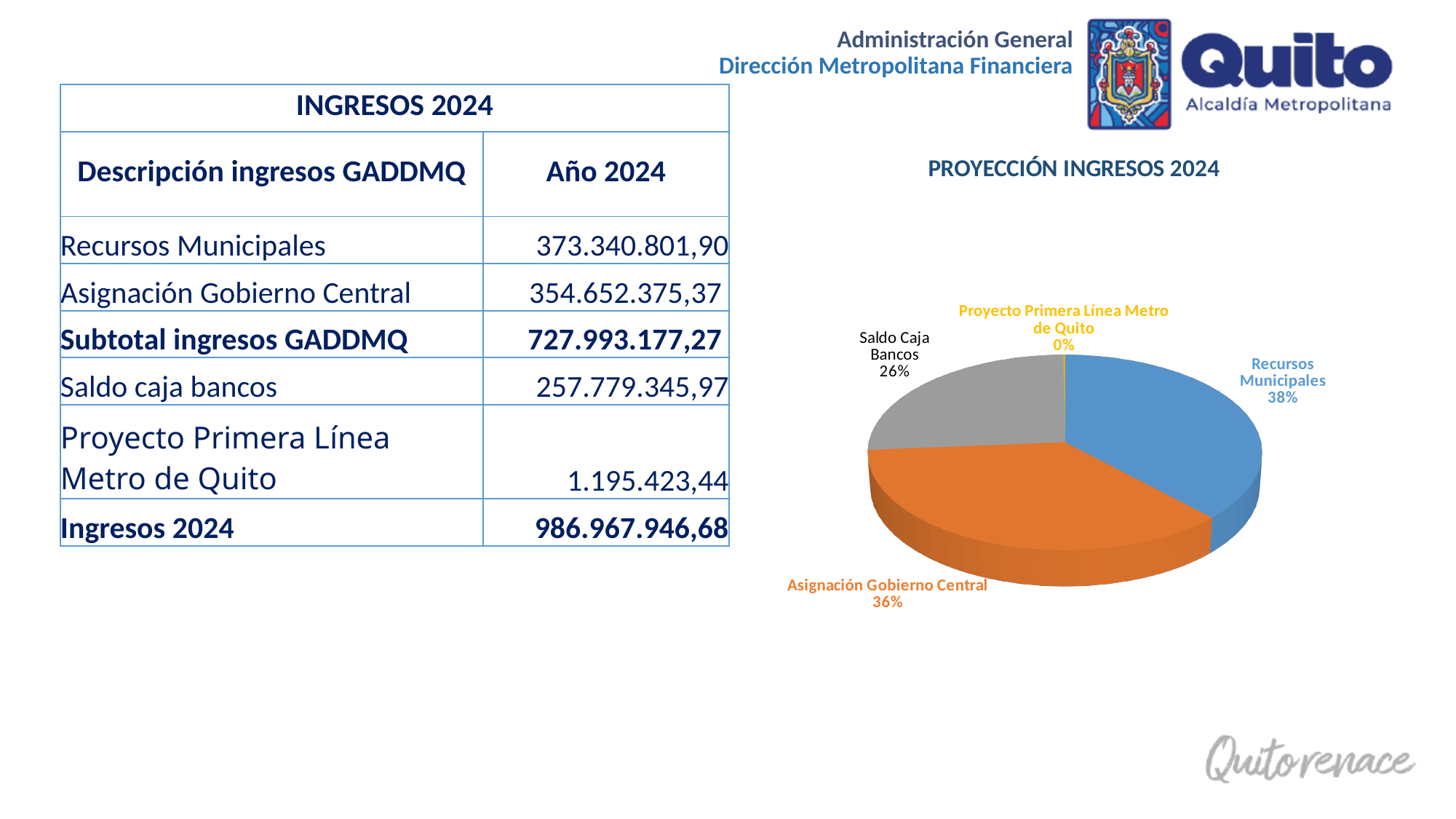
What colour is the Asignación Gobierno Central slice in the pie chart? Orange Which slice of the pie chart is the largest? Recursos Municipales In the pie chart, what is the difference in percentage points between Recursos Municipales and Saldo Caja Bancos? 12 How many slices are labelled in the pie chart? 4 What percentage is shown for Proyecto Primera Línea Metro de Quito in the pie chart? 0% What share of the pie chart does Saldo Caja Bancos represent? 26% What kind of chart is shown under the title PROYECCIÓN INGRESOS 2024? Pie chart What share of the pie chart does Asignación Gobierno Central represent? 36% What share of the pie chart does Recursos Municipales represent? 38% What is the title of the pie chart? PROYECCIÓN INGRESOS 2024 Which slice of the pie chart is the smallest? Proyecto Primera Línea Metro de Quito In the pie chart, which is larger: Asignación Gobierno Central or Saldo Caja Bancos? Asignación Gobierno Central